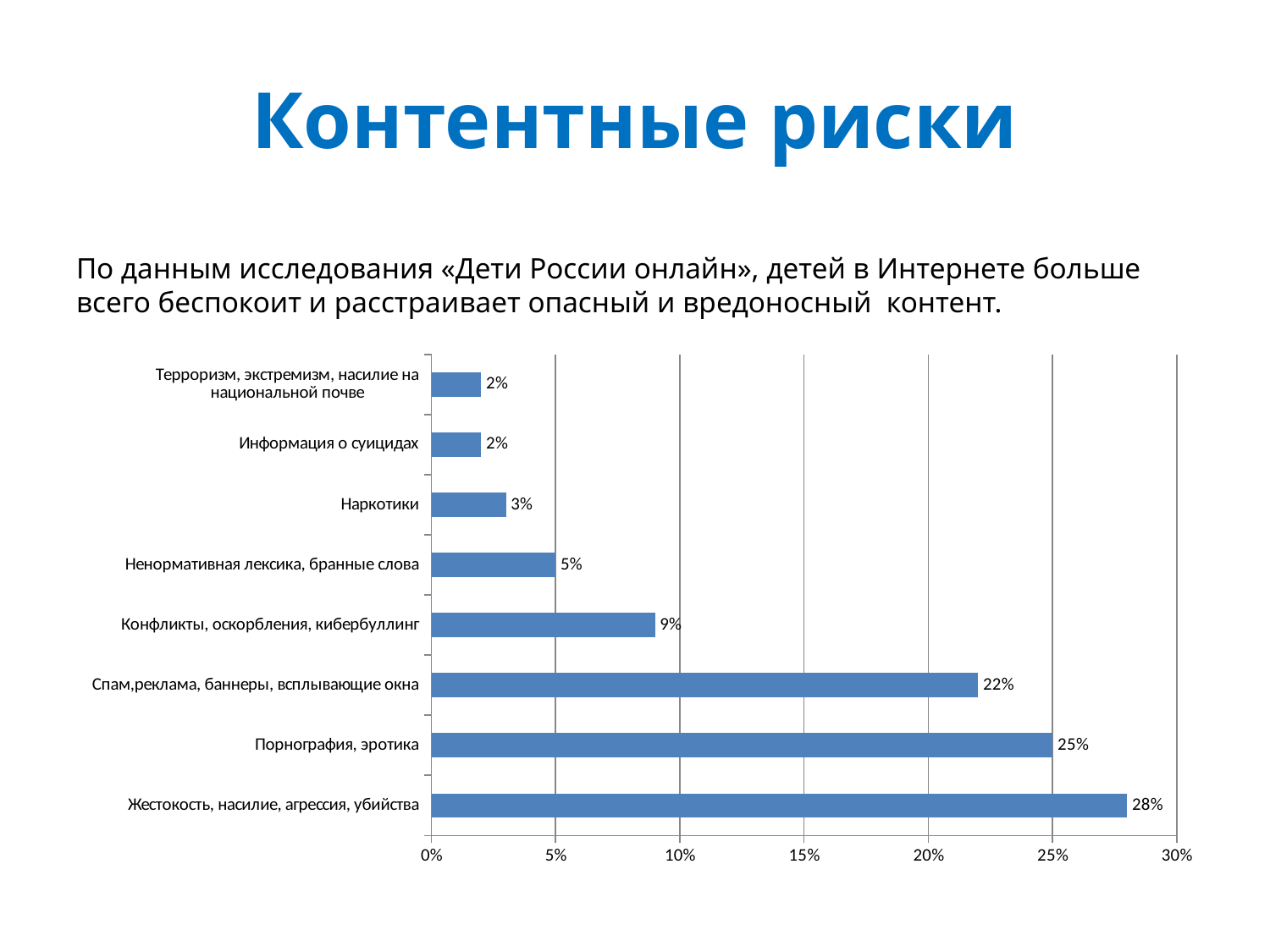
What is the value for «Жестокость, насилие, агрессия, убийства»? 28% What kind of chart is shown on the slide? bar chart What is the difference between «Жестокость, насилие, агрессия, убийства» and «Порнография, эротика»? 3% Which category has the highest value? Жестокость, насилие, агрессия, убийства What is the maximum value shown on the horizontal axis? 30% What is the value for «Информация о суицидах»? 2% How many categories are shown in the chart? 8 What is the difference between «Порнография, эротика» and «Конфликты, оскорбления, кибербуллинг»? 16% What is the value for «Спам,реклама, баннеры, всплывающие окна»? 22% What is the value for «Наркотики»? 3% Is the value for «Спам,реклама, баннеры, всплывающие окна» greater or less than 20%? greater Which is larger: «Ненормативная лексика, бранные слова» or «Наркотики»? Ненормативная лексика, бранные слова